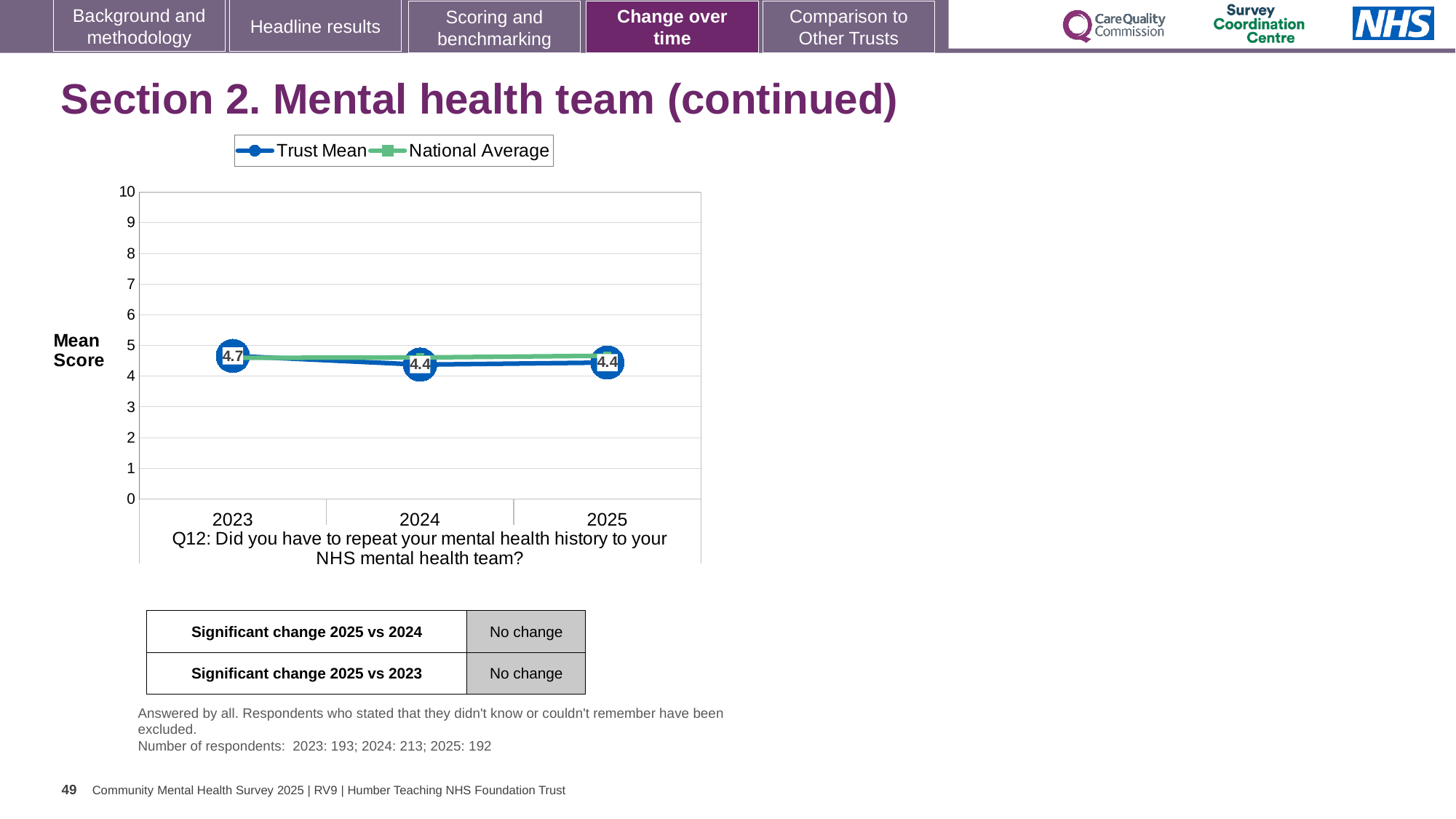
Which is larger, the Trust Mean score for 2023 or for 2025? 2023 Is the National Average value for 2025 greater or less than 5? less Does the Trust Mean score rise or fall from 2023 to 2025? fall In which year is the Trust Mean score highest? 2023 How many series does the chart legend list? 2 What is the label on the y axis of the chart? Mean Score How many years are shown on the x axis of the chart? 3 What is the difference between the Trust Mean score in 2023 and in 2024? 0.3 What is the Trust Mean score for 2025? 4.4 What kind of chart is shown on the slide? line chart What is the Trust Mean score for 2023? 4.7 What is the Trust Mean score for 2024? 4.4